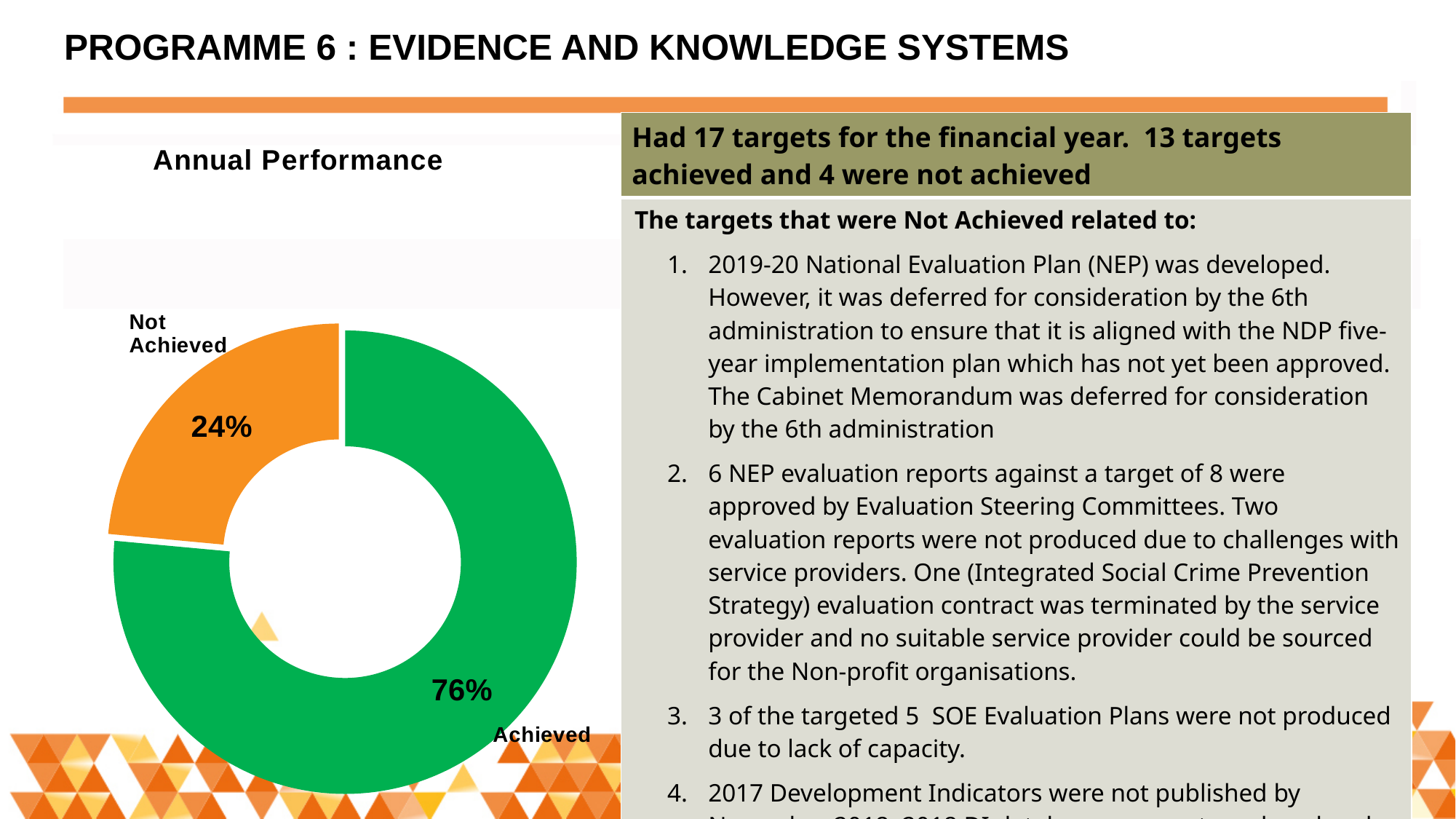
Which category has the smallest share in the Annual Performance chart? Not Achieved What is the difference in percentage points between Achieved and Not Achieved in the Annual Performance chart? 52 What colour is the Achieved segment in the Annual Performance chart? Green Which is larger in the Annual Performance chart, Achieved or Not Achieved? Achieved How many categories are shown in the Annual Performance chart? 2 Which category has the largest share in the Annual Performance chart? Achieved What kind of chart is the Annual Performance chart? Doughnut (pie) chart What share of the Annual Performance chart does the Not Achieved slice represent? 24% What is the title of the chart on the slide? Annual Performance What percentage of targets were Achieved according to the Annual Performance chart? 76% What percentage of targets were Not Achieved according to the Annual Performance chart? 24%